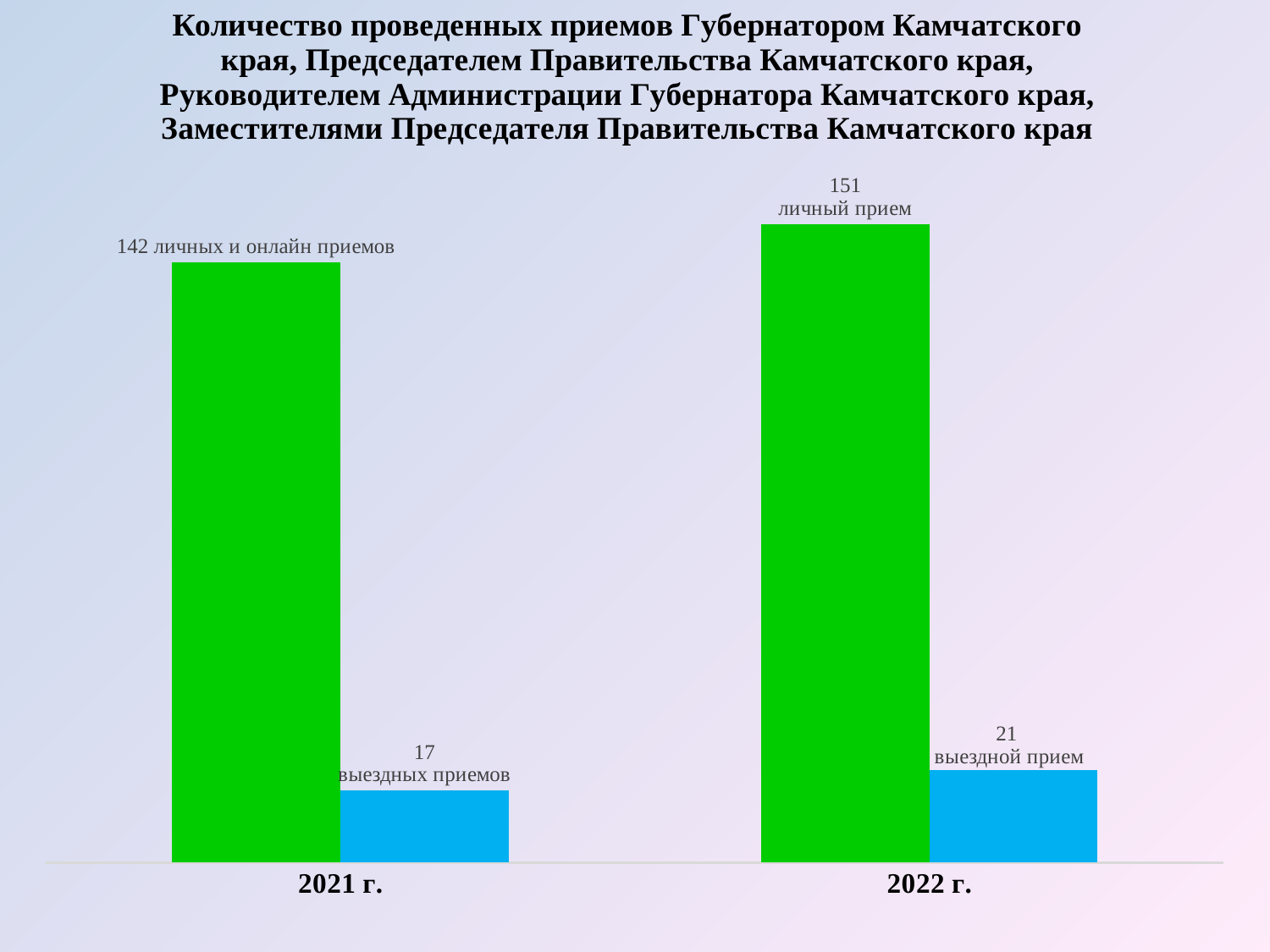
How many personal receptions (личный прием) were held in 2022 г.? 151 What is the difference between the number of personal receptions in 2022 г. and in 2021 г.? 9 How many field receptions (выездной прием) were held in 2022 г.? 21 What type of chart is shown on the slide? Bar chart Does the number of personal receptions rise or fall from 2021 г. to 2022 г.? Rise How many personal and online receptions (личных и онлайн приемов) were held in 2021 г.? 142 What is the difference between the number of field receptions in 2022 г. and in 2021 г.? 4 Which year has the higher number of personal receptions, 2021 г. or 2022 г.? 2022 г. Which year has the lower number of field receptions, 2021 г. or 2022 г.? 2021 г. What is the difference between personal receptions and field receptions in 2021 г.? 125 How many field receptions (выездных приемов) were held in 2021 г.? 17 How many years (categories) are shown on the x axis? 2